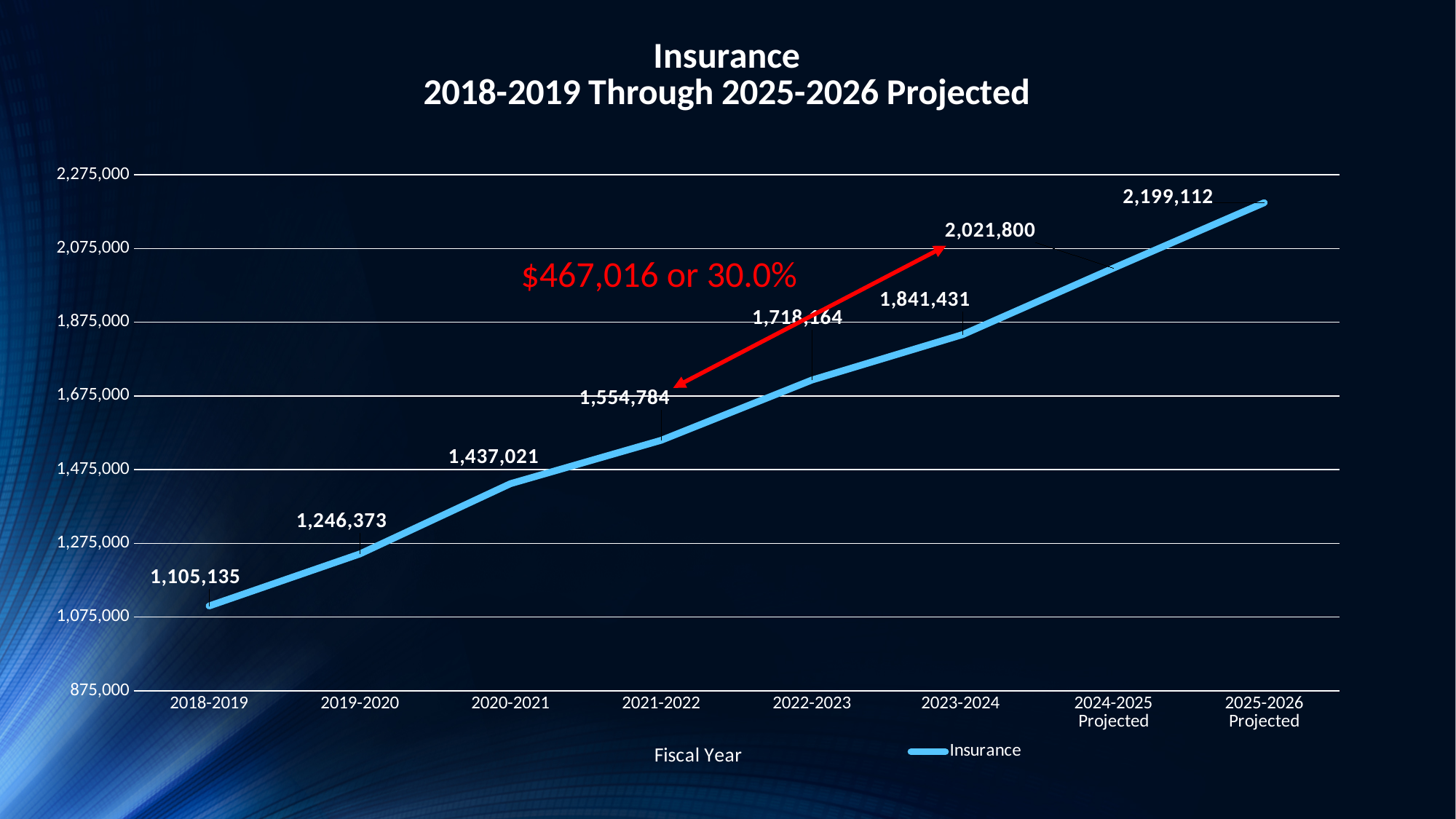
What is the Insurance value for 2023-2024? 1,841,431 What is the projected Insurance value for 2025-2026? 2,199,112 Which is larger, the Insurance value for 2022-2023 or for 2020-2021? 2022-2023 Which fiscal year has the highest Insurance value? 2025-2026 Projected How many fiscal years are plotted on the chart? 8 Do the Insurance values rise or fall from 2018-2019 to 2025-2026 Projected? Rise What is the difference between the Insurance values for 2025-2026 Projected and 2018-2019? 1,093,977 What is the Insurance value for 2018-2019? 1,105,135 What kind of chart is shown on the slide? Line chart What is the difference between the Insurance values for 2019-2020 and 2018-2019? 141,238 Which fiscal year has the lowest Insurance value? 2018-2019 What is the Insurance value for 2021-2022? 1,554,784